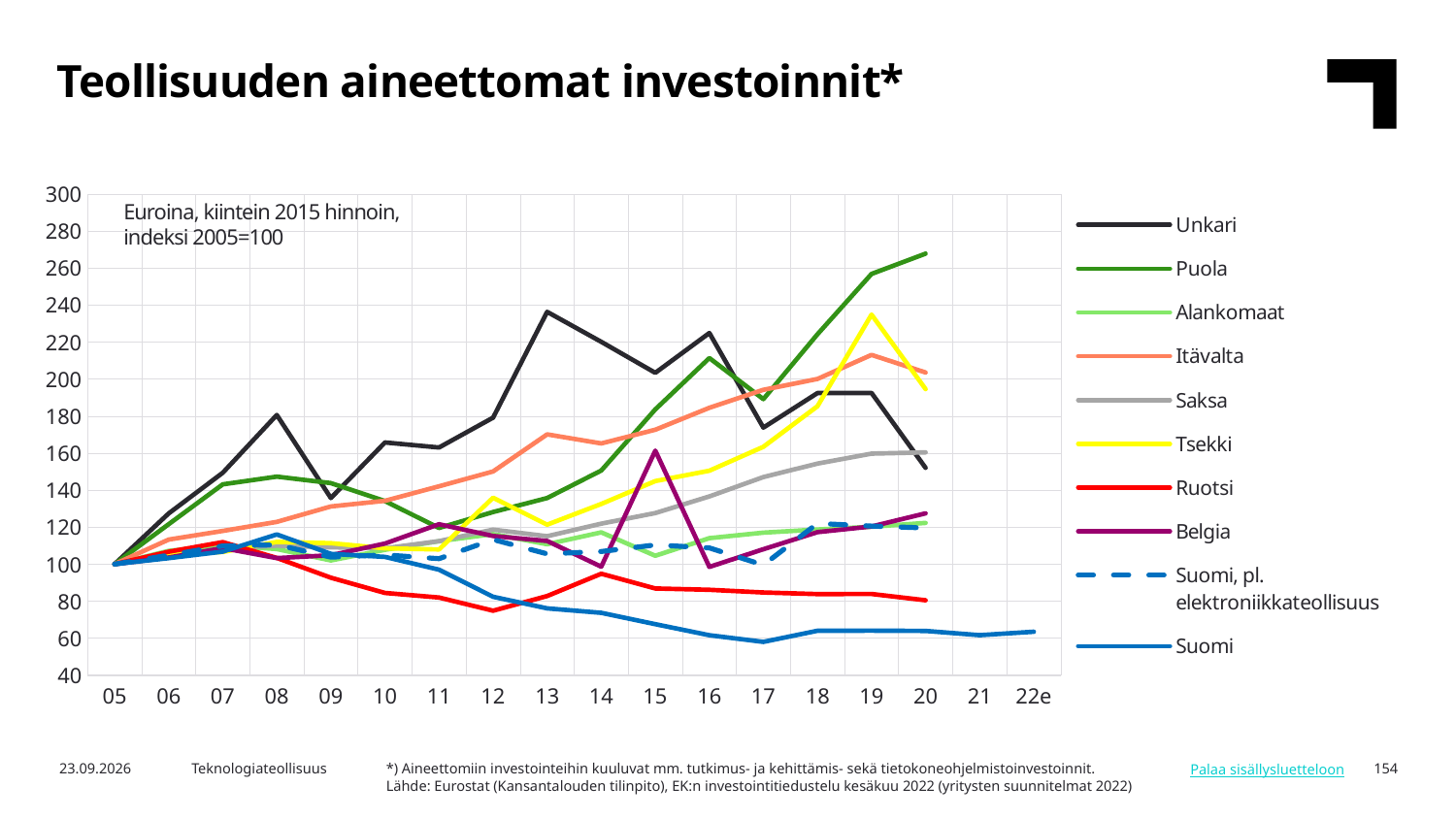
Is the value for Unkari in 2013 greater or less than 220? greater What is the index value of the series in the base year 2005? 100 Which series is drawn with a dashed line? Suomi, pl. elektroniikkateollisuus How many series does the legend list? 10 Which is higher in 2020, Itävalta or Saksa? Itävalta Does the Suomi series rise or fall overall from 2005 to 2020? fall Is the value for Puola in 2020 greater or less than 260? greater Is the value for Ruotsi in 2012 greater or less than 80? less Which series has the lowest value in 2020? Suomi Which series has the highest value in 2020? Puola What kind of chart is shown on the slide? line chart